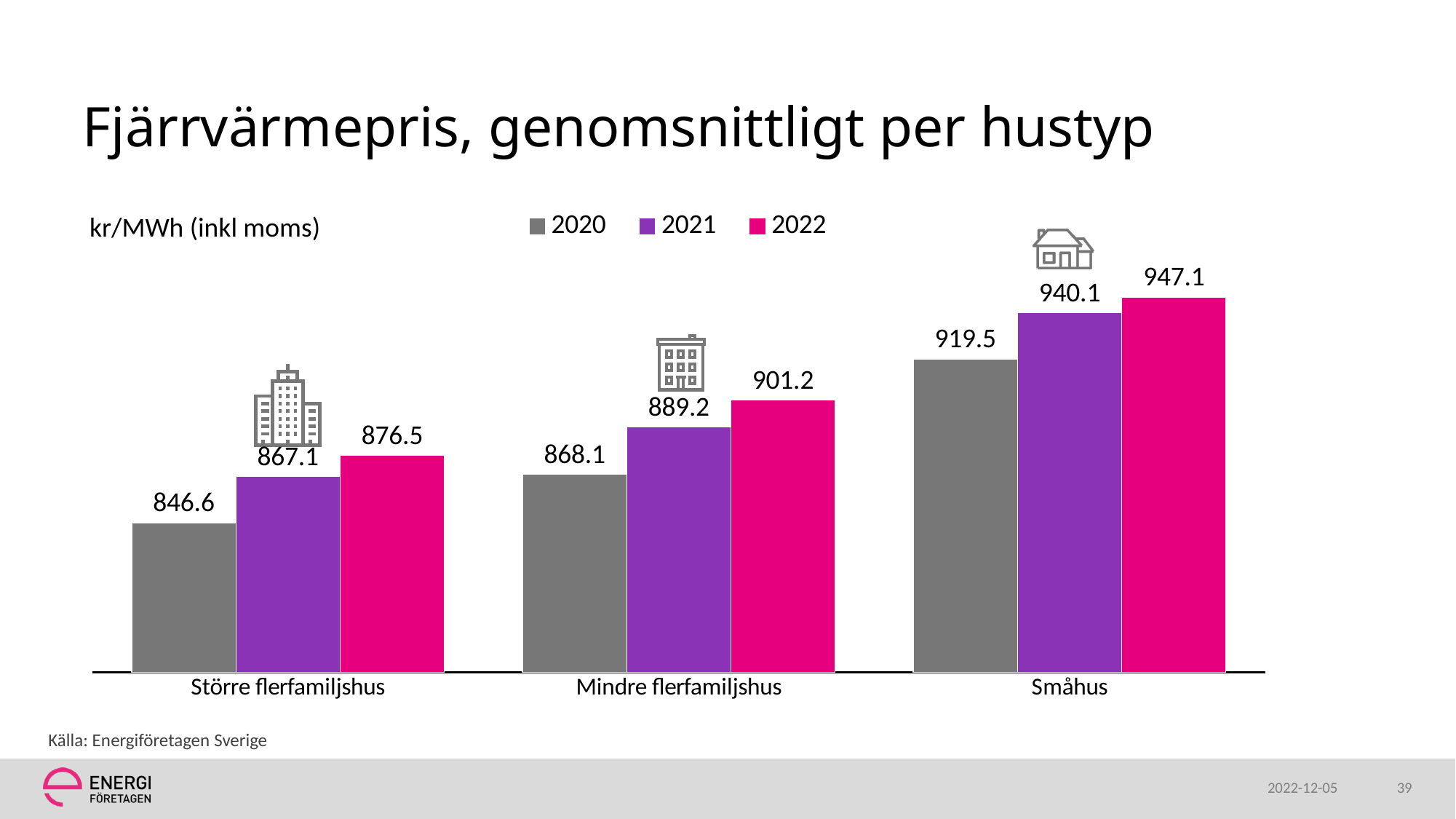
Which house type has the lowest value in 2020? Större flerfamiljshus How many series does the legend list? 3 What is the difference between the 2022 and 2020 values for Småhus? 27.6 What is the value for Småhus in 2022? 947.1 What is the difference between the 2021 values for Mindre flerfamiljshus and Större flerfamiljshus? 22.1 How many house type categories are shown on the x axis? 3 What unit is stated for the values in the chart? kr/MWh (inkl moms) What is the value for Mindre flerfamiljshus in 2021? 889.2 Which is larger: the 2022 value for Mindre flerfamiljshus or the 2020 value for Småhus? 2020 value for Småhus What kind of chart is shown on the slide? Bar chart Which house type has the highest value in 2022? Småhus What is the value for Större flerfamiljshus in 2020? 846.6